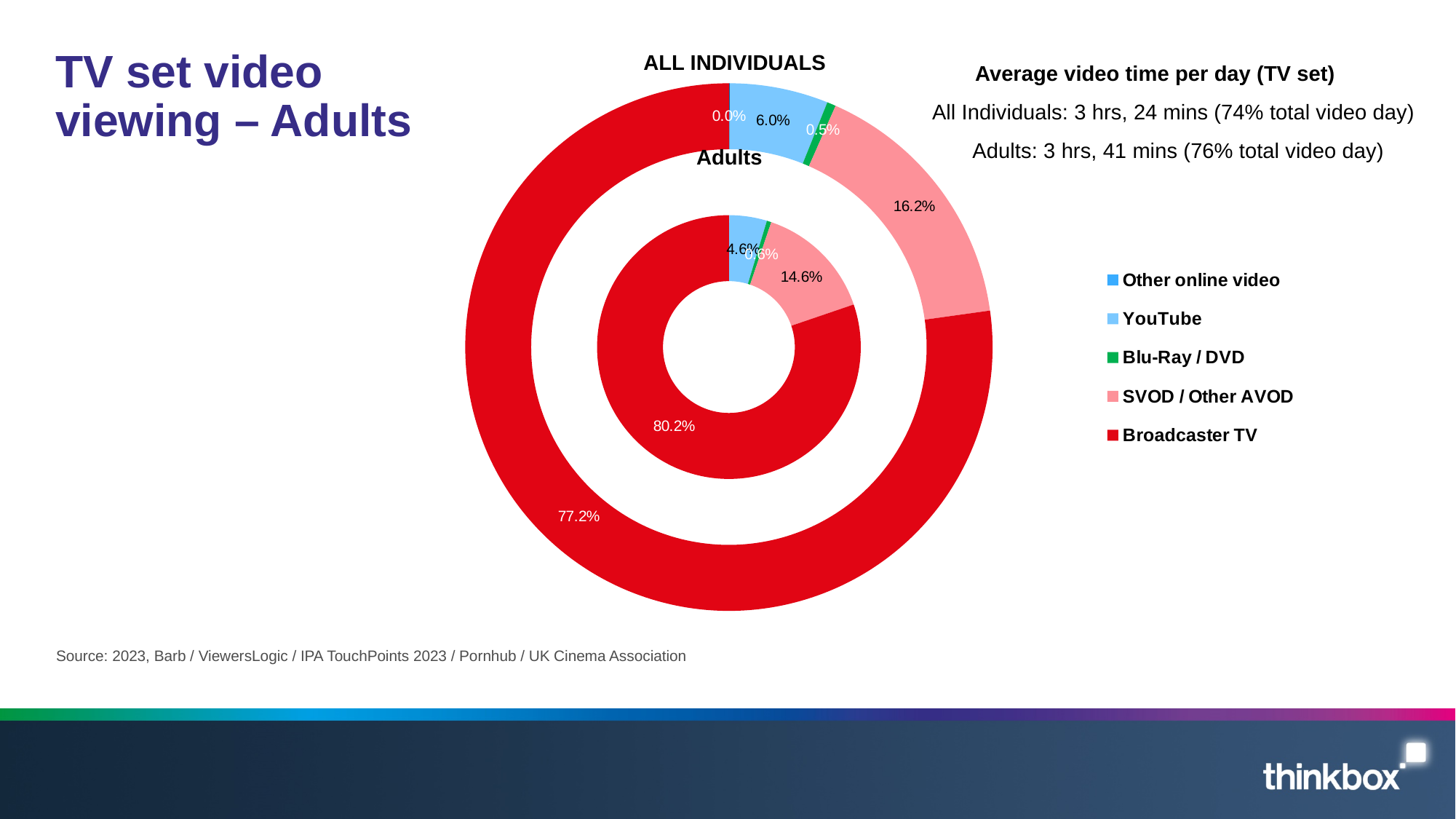
What share of TV set video viewing for All Individuals is Broadcaster TV? 77.2% Which category has the largest share in the Adults ring? Broadcaster TV What is the YouTube share for All Individuals? 6.0% What is the SVOD / Other AVOD share for All Individuals? 16.2% What kind of chart is shown on the slide? Doughnut (pie) chart What is the difference between the Broadcaster TV share for Adults and for All Individuals? 3.0% What is the Blu-Ray / DVD share for All Individuals? 0.5% What is the SVOD / Other AVOD share for Adults? 14.6% What share of TV set video viewing for Adults is Broadcaster TV? 80.2% Is the YouTube share larger for All Individuals or for Adults? All Individuals What is the YouTube share for Adults? 4.6% How many categories does the legend list? 5